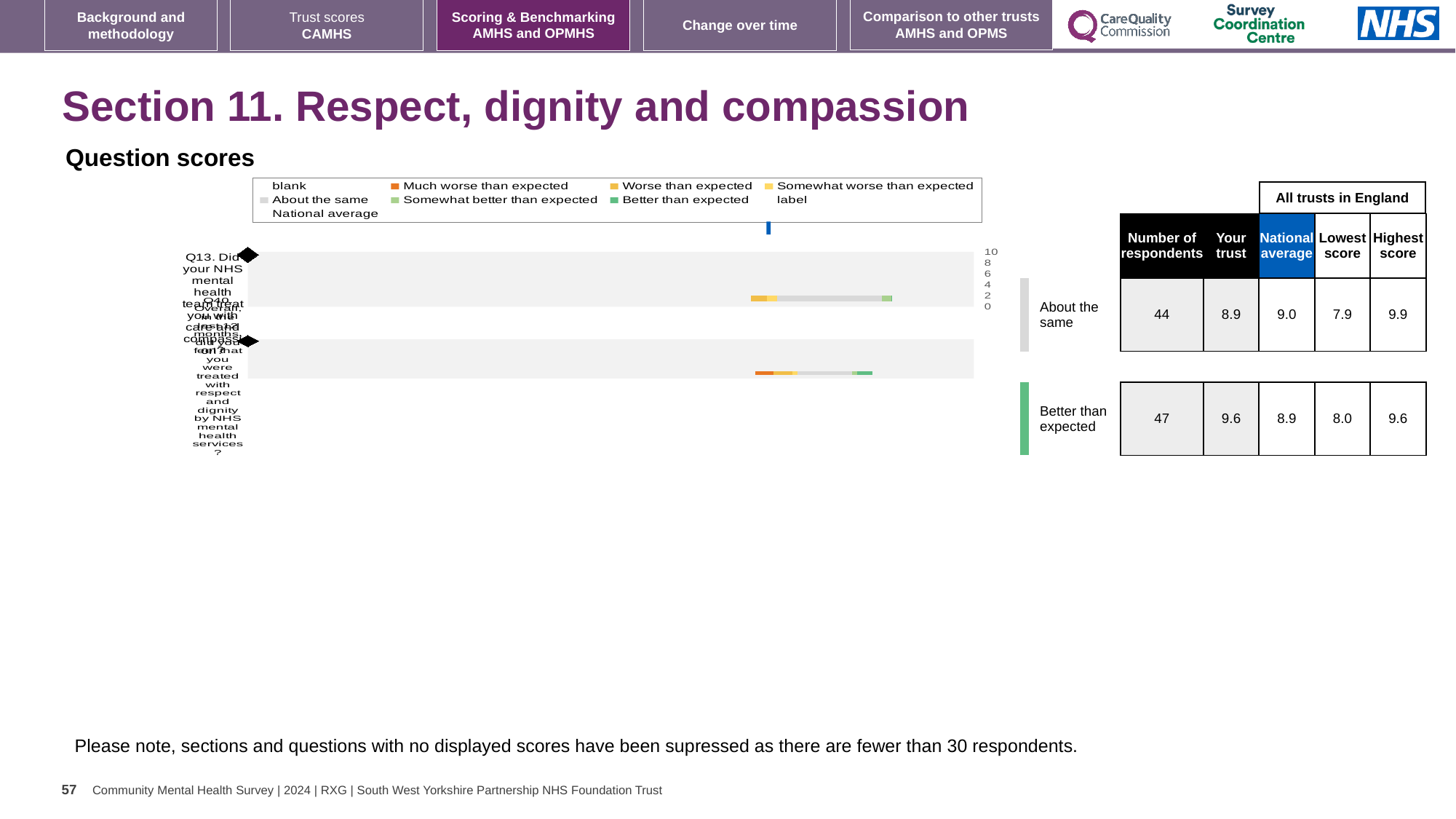
In the table beside the chart, what is the number of respondents for the row rated 'About the same'? 44 How many questions (rows) are plotted in the Question scores chart? 2 What is the 'Your trust' score for the row rated 'Better than expected'? 9.6 For the row rated 'Better than expected', which is larger: the 'Your trust' score or the national average? Your trust What is the national average for the row rated 'About the same'? 9.0 What is the lowest score among all trusts in England for the row rated 'Better than expected'? 8.0 What kind of chart is shown under 'Question scores'? bar chart What is the highest score among all trusts in England for the row rated 'About the same'? 9.9 For the row rated 'About the same', what is the difference between the highest score and the lowest score? 2.0 Which row has more respondents, 'About the same' or 'Better than expected'? Better than expected What heading appears above the National average, Lowest score and Highest score columns in the table? All trusts in England In the table beside the chart, what is the number of respondents for the row rated 'Better than expected'? 47